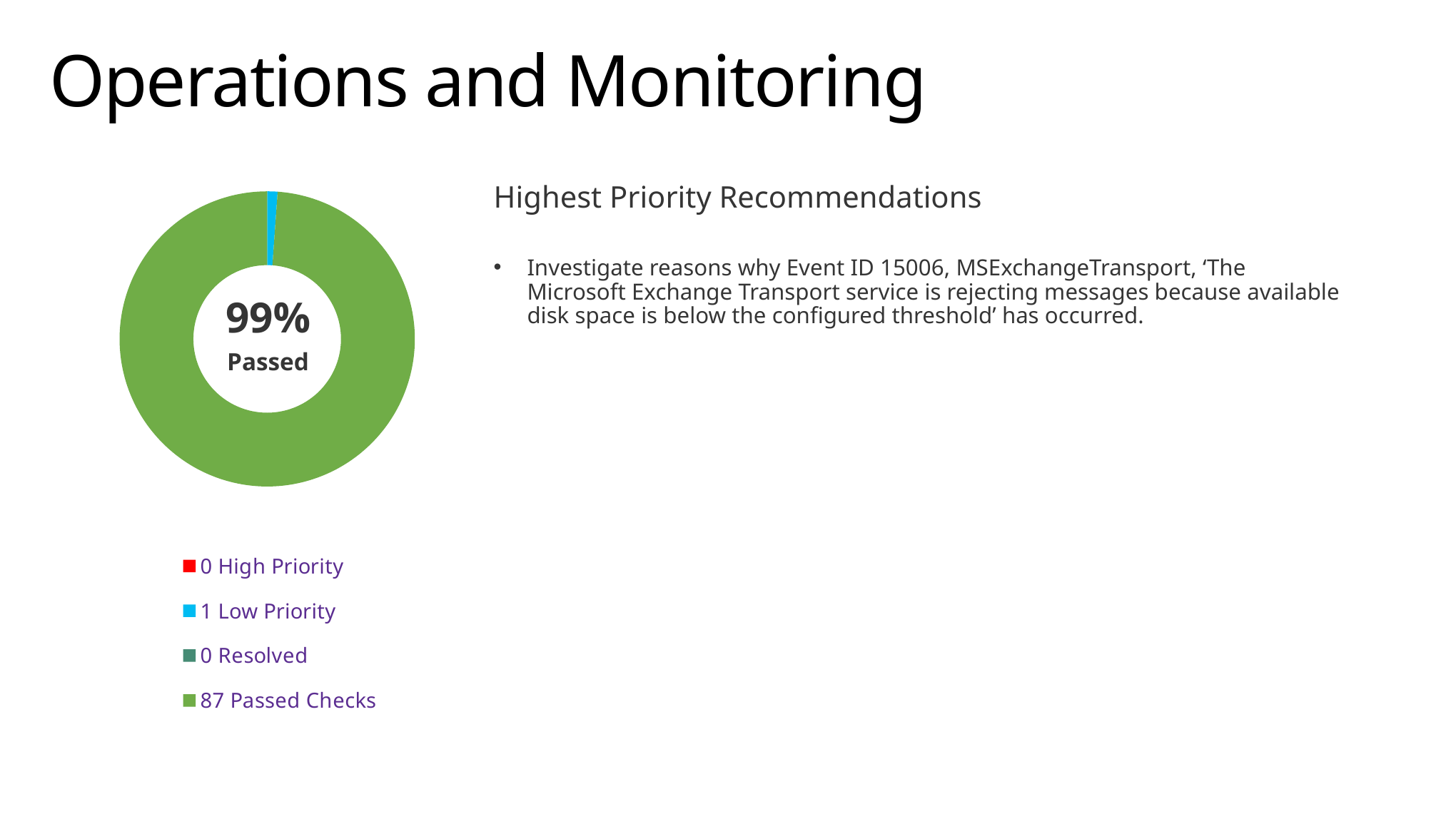
How many High Priority items does the chart's legend show? 0 How many categories does the chart's legend list? 4 What kind of chart is shown on the slide? Pie chart (donut) How many Low Priority items does the chart's legend show? 1 How many Resolved items does the chart's legend show? 0 What percentage is shown in the centre of the chart as Passed? 99% How many Passed Checks does the chart's legend show? 87 What is the difference between the number of Passed Checks and the number of Low Priority items? 86 Which is larger, the number of Low Priority items or the number of Passed Checks? Passed Checks What is the total number of items across all categories in the chart's legend? 88 What colour represents Low Priority in the chart? Blue Which category has the largest share of the chart? Passed Checks